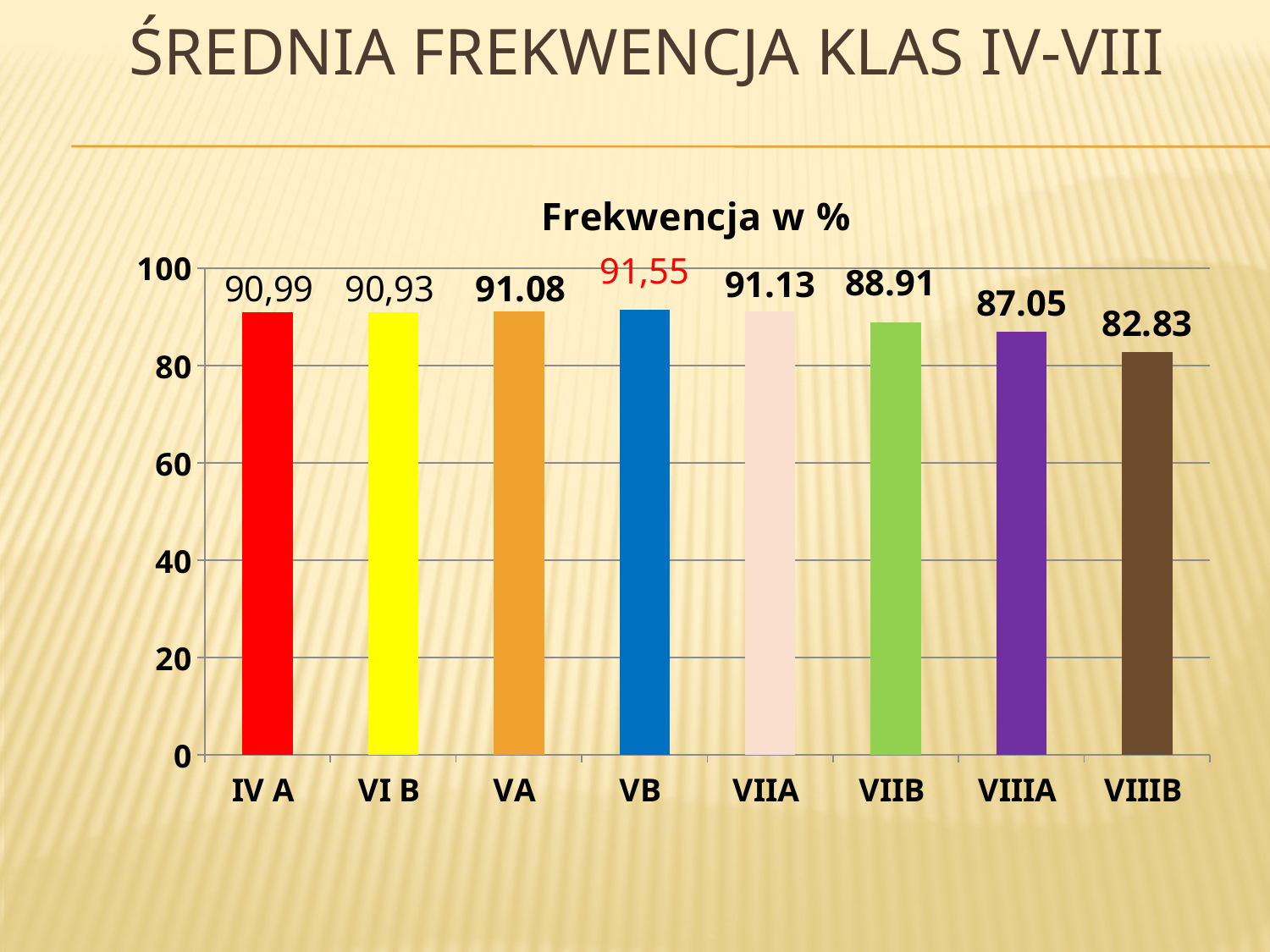
Which class has the lowest value? VIIIB What is the value for IV A? 90,99 What is the difference between the values for VIIIA and VIIIB? 4.22 Is the value for VIIIB greater or less than 80? greater What is the value for VIIB? 88.91 Which is larger, the value for VIIB or the value for VIIIB? VIIB Which class has the highest value? VB What is the title of the chart? Frekwencja w % What is the value for VIIIB? 82.83 What kind of chart is shown on the slide? bar chart What is the value for VA? 91.08 How many classes are shown on the chart? 8